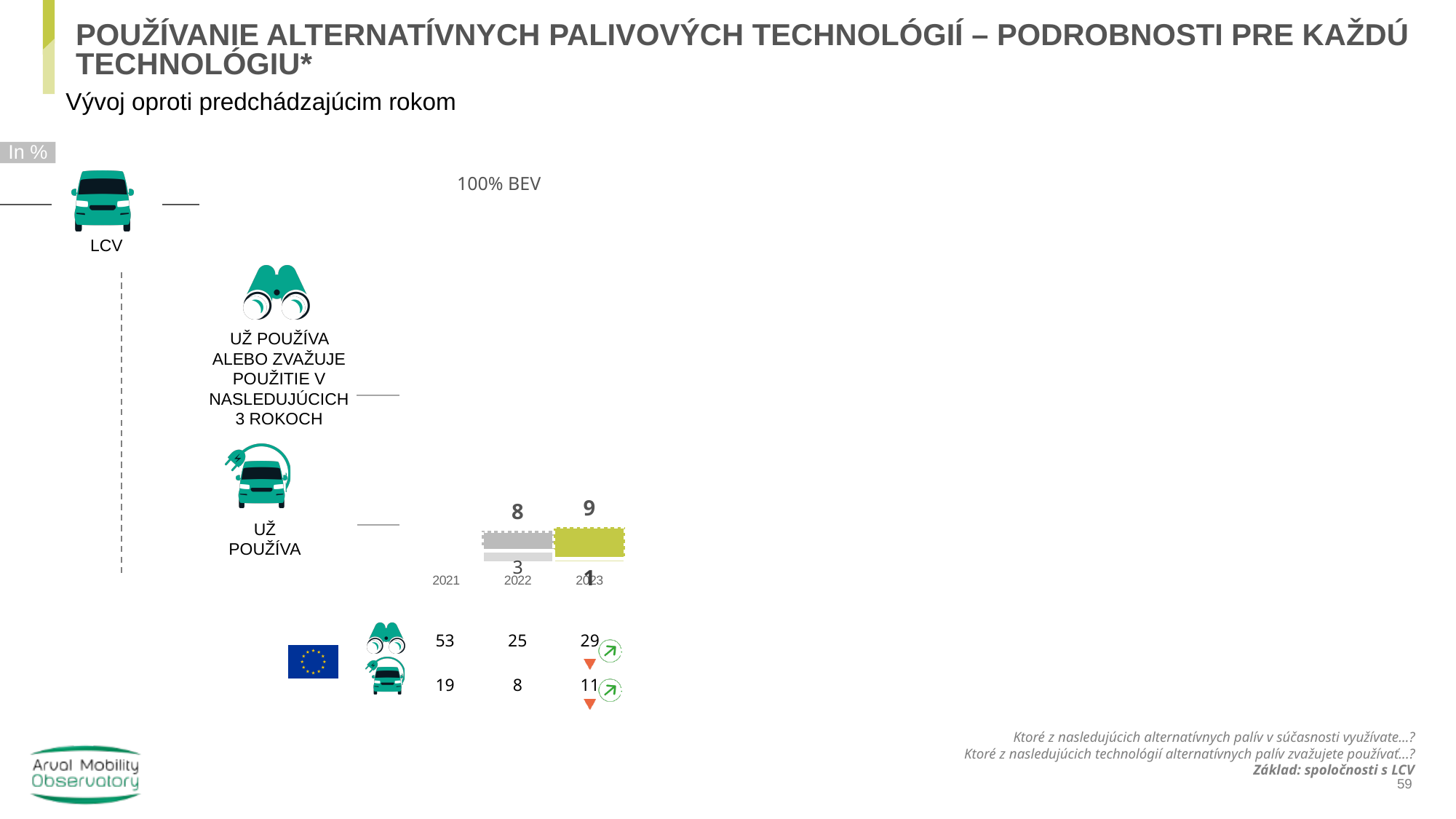
What is the EU reference value for 2023 in the 'Už používa alebo zvažuje' row below the chart? 29 What is the value for 2023 in the 'Už používa alebo zvažuje použitie v nasledujúcich 3 rokoch' row of the 100% BEV chart? 9 In the 100% BEV chart, what is the difference between the 2023 and 2022 values in the 'Už používa alebo zvažuje' row? 1 Which years are labelled on the x axis of the 100% BEV chart? 2021, 2022, 2023 What is the value for 2022 in the 'Už používa alebo zvažuje použitie v nasledujúcich 3 rokoch' row of the 100% BEV chart? 8 What is the EU reference value for 2021 in the 'Už používa' row below the chart? 19 What kind of chart is used to show the 100% BEV values? bar chart In the 100% BEV chart, does the 'Už používa alebo zvažuje' value rise or fall from 2022 to 2023? rise What is the value for 2022 in the 'Už používa' row of the 100% BEV chart? 3 How many years are labelled on the x axis of the 100% BEV chart? 3 In the 100% BEV chart, which year has the higher value in the 'Už používa alebo zvažuje' row, 2022 or 2023? 2023 What colour is the 2023 bar in the 100% BEV chart? yellow-green